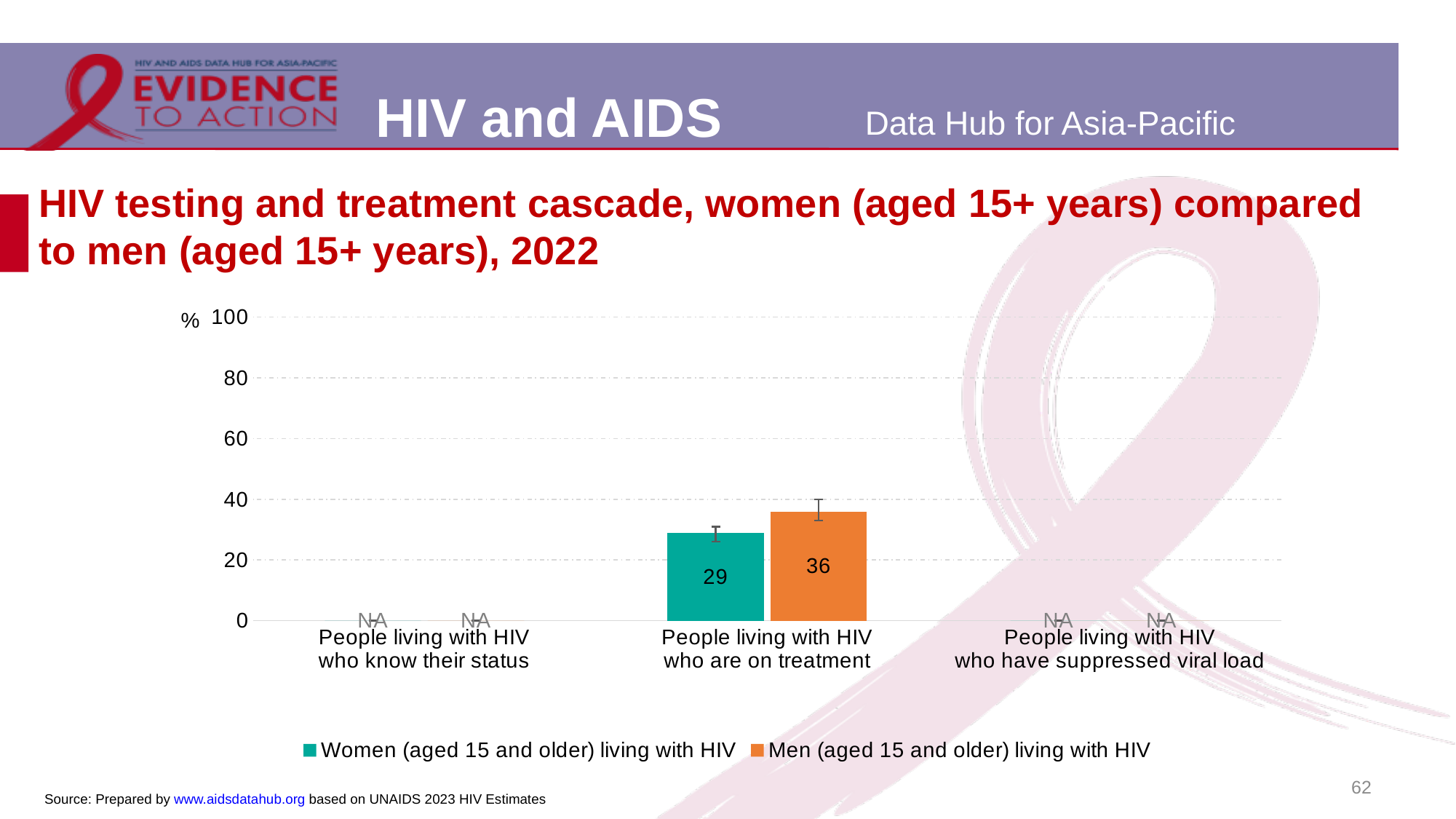
How many series does the legend list? 2 What colour represents women (aged 15 and older) living with HIV in the chart? Teal (green) What is the value for women (aged 15 and older) living with HIV who are on treatment? 29 Is the value for men living with HIV who are on treatment greater or less than 40? less What is the difference between the men's and women's values for people living with HIV who are on treatment? 7 Is the value for women living with HIV who are on treatment greater or less than 20? greater For people living with HIV who are on treatment, which series has the larger value, women or men? Men (aged 15 and older) living with HIV How many categories are shown on the x axis? 3 What kind of chart is shown on the slide? Bar chart What is shown for the category 'People living with HIV who know their status'? NA What is the value for men (aged 15 and older) living with HIV who are on treatment? 36 What is shown for the category 'People living with HIV who have suppressed viral load'? NA